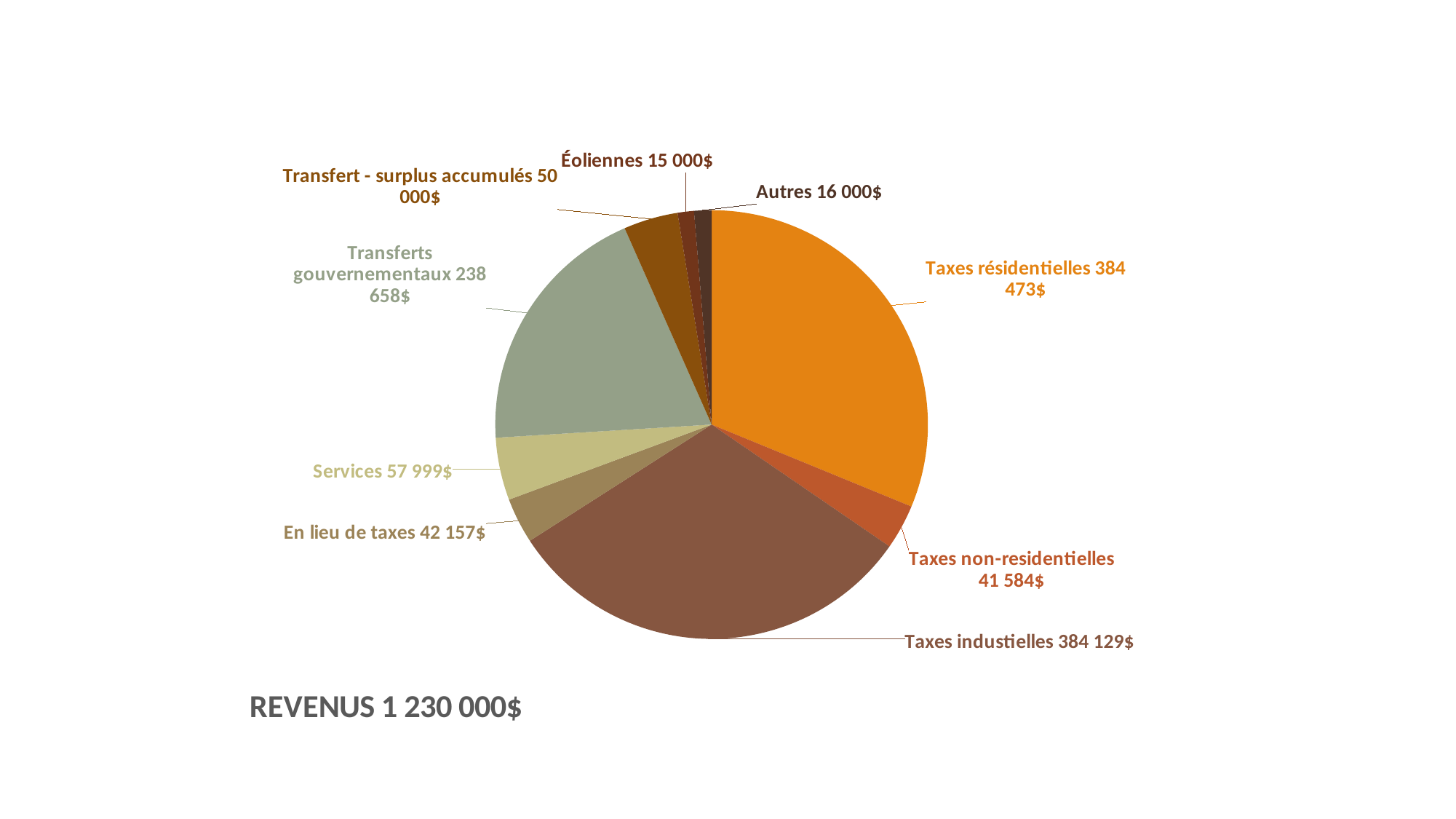
Which is larger, Transferts gouvernementaux or Services? Transferts gouvernementaux What is the value for Services? 57 999$ What is the value for Taxes résidentielles? 384 473$ What is the value for Éoliennes? 15 000$ What is the value for Transferts gouvernementaux? 238 658$ Which is larger, Taxes industielles or Transfert - surplus accumulés? Taxes industielles How many slices does the pie chart have? 9 What kind of chart is shown on the slide? Pie chart What is the difference between Services and En lieu de taxes? 15 842$ What is the difference between Transferts gouvernementaux and Transfert - surplus accumulés? 188 658$ What total revenue (REVENUS) is stated on the slide? 1 230 000$ What is the value for Taxes non-residentielles? 41 584$